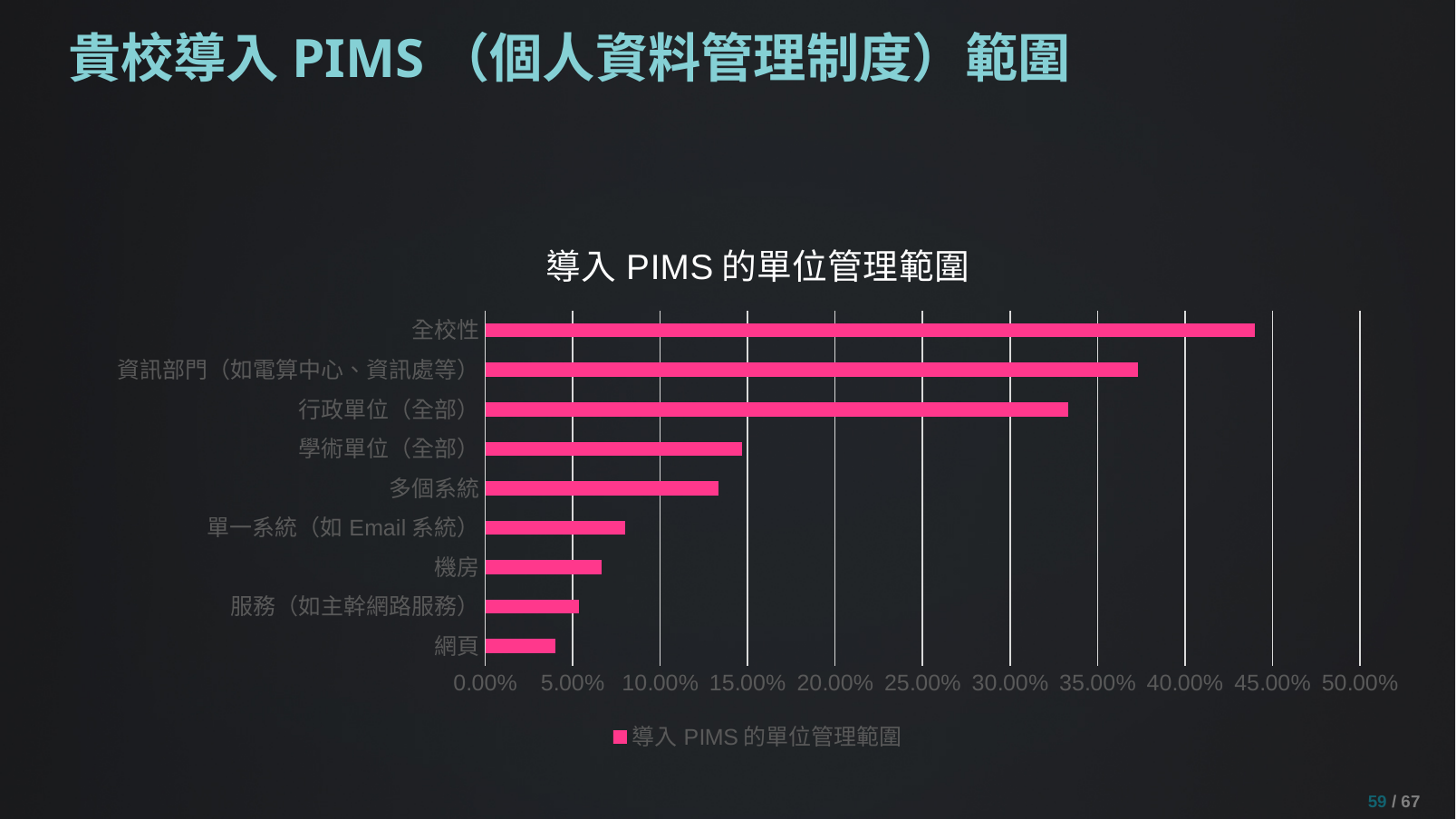
What kind of chart is shown on the slide? bar chart How many series does the legend list? 1 Which category has the highest value? 全校性 Which is larger, the value for 行政單位（全部） or the value for 學術單位（全部）? 行政單位（全部） What is the title of the chart? 導入 PIMS 的單位管理範圍 Is the value for 行政單位（全部） greater or less than 30.00%? greater Is the value for 網頁 greater or less than 5.00%? less Is the value for 全校性 greater or less than 40.00%? greater How many categories are plotted in the chart? 9 Which category has the lowest value? 網頁